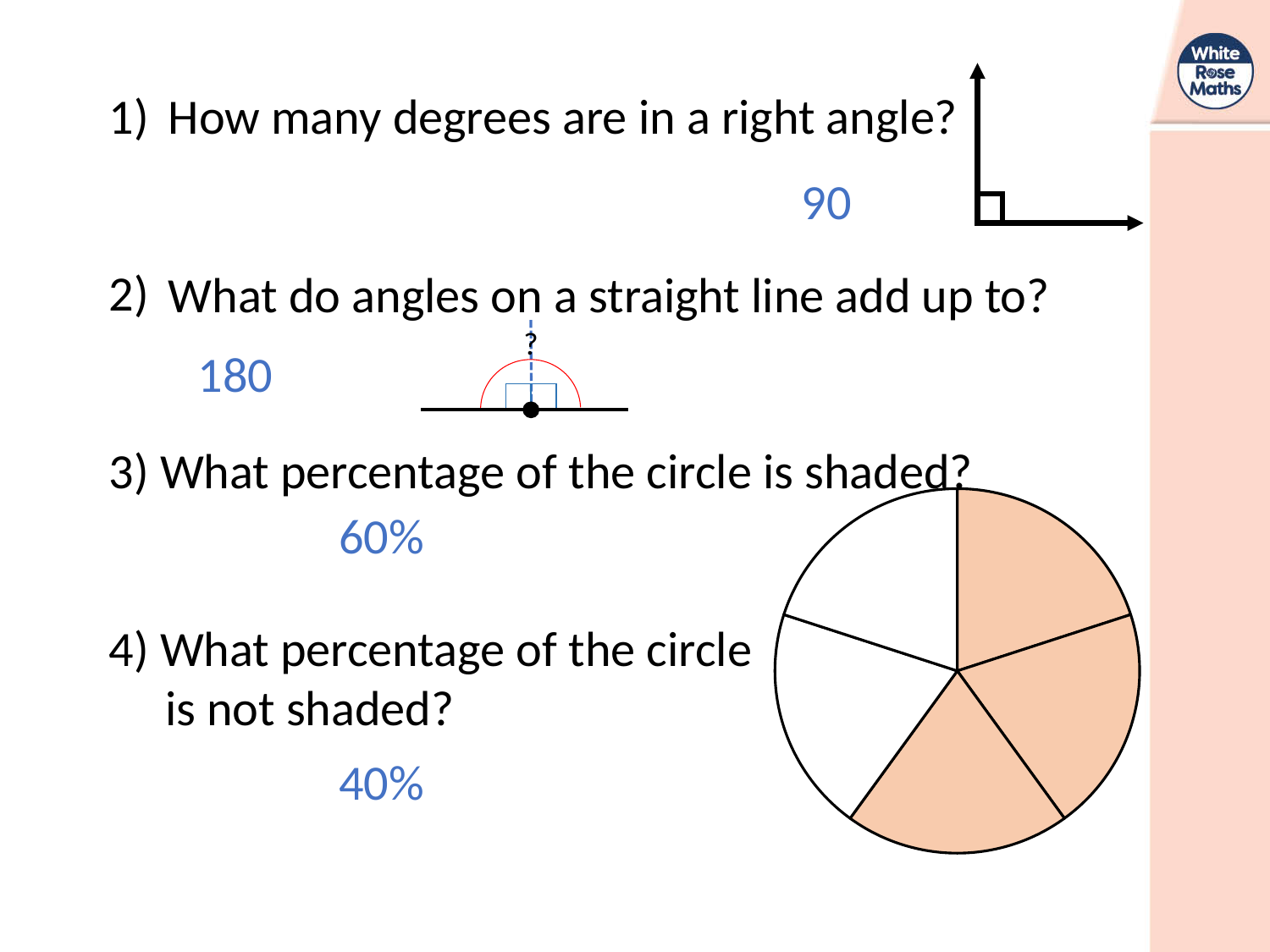
What colour are the shaded sectors of the circle on the slide? orange According to the slide, what percentage of the circle is shaded? 60% Is the shaded part of the circle larger or smaller than the unshaded part? larger How many equal sectors is the circle on the slide divided into? 5 According to the slide, what percentage of the circle is not shaded? 40% How many sectors of the circle on the slide are shaded? 3